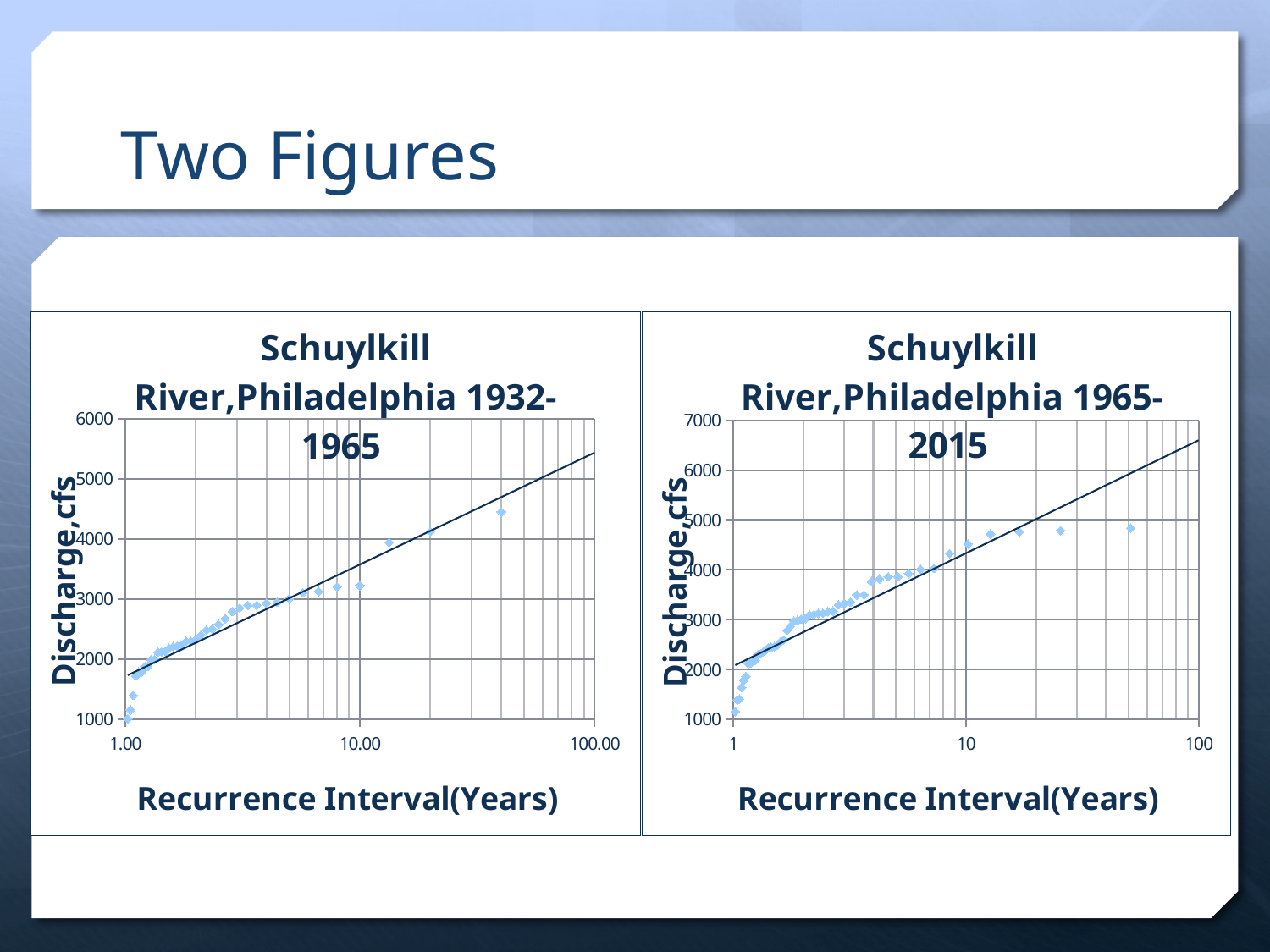
In the left chart (1932-1965), is the discharge of the point with the largest recurrence interval greater or less than 5000? less In the left chart (1932-1965), is the discharge of the point with the largest recurrence interval greater or less than 4000? greater In the left chart (1932-1965), do the discharge values rise or fall as the recurrence interval increases? rise In the left chart (1932-1965), is the discharge of the point at a recurrence interval of 1.00 year greater or less than 2000? less What is the highest value shown on the y axis of the right chart (1965-2015)? 7000 What kind of chart is the left chart, titled 'Schuylkill River,Philadelphia 1932-1965'? scatter chart What kind of chart is the right chart, titled 'Schuylkill River,Philadelphia 1965-2015'? scatter chart What is the x-axis title of the left chart (1932-1965)? Recurrence Interval(Years) In the right chart (1965-2015), do the discharge values rise or fall as the recurrence interval increases? rise